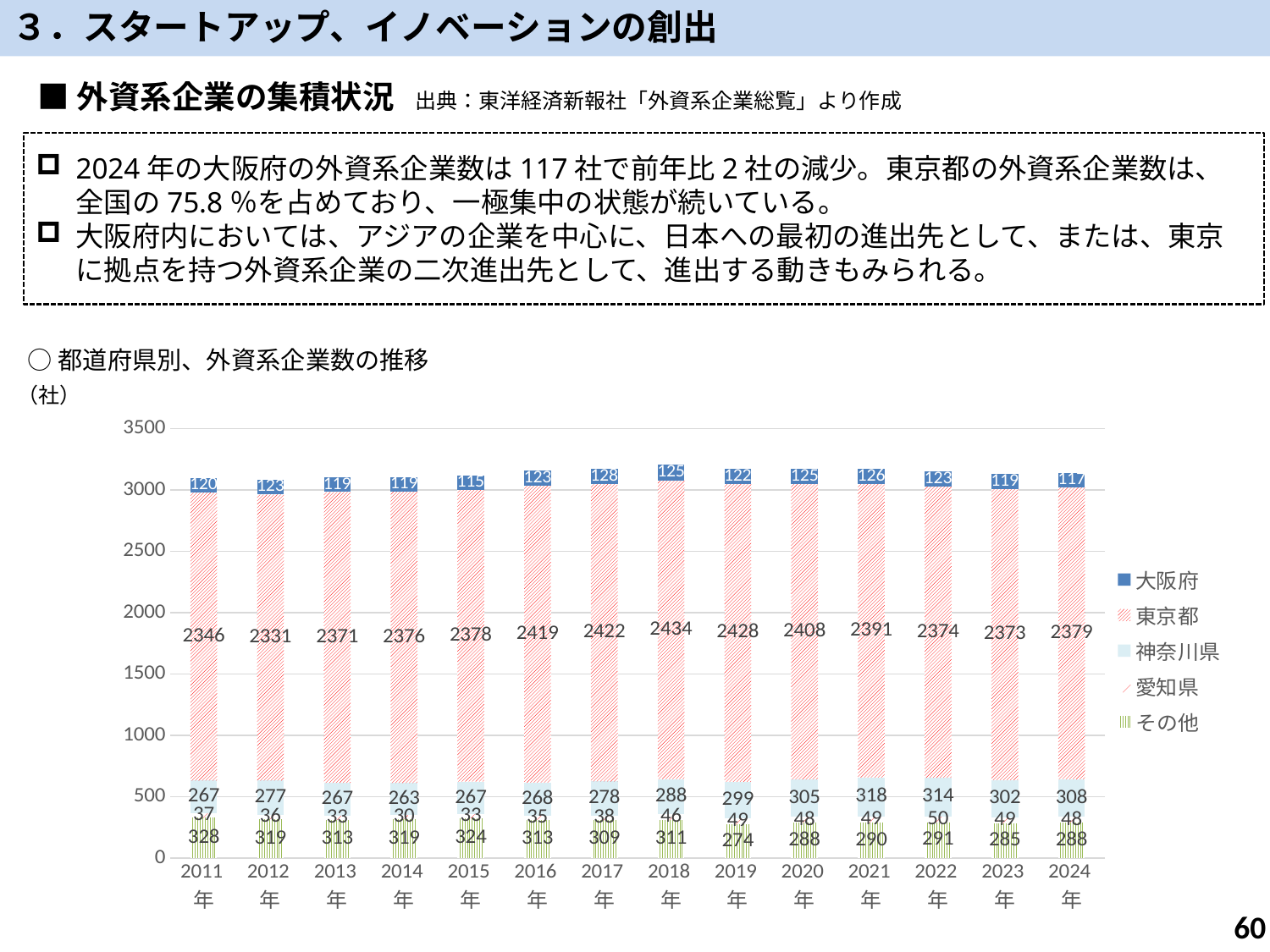
What is the value for その他 in 2019年? 274 In which year is the value for 大阪府 the lowest? 2015年 What is the difference between the 大阪府 values for 2023年 and 2024年? 2 What is the value for 東京都 in 2018年? 2434 What is the total of the stacked bar for 2024年? 3140 What is the value for 大阪府 in 2024年? 117 How many years are shown on the x axis? 14 What kind of chart is shown? Stacked bar chart Which is larger, the 神奈川県 value in 2011年 or in 2024年? 2024年 In which year is the value for 東京都 the highest? 2018年 What is the value for 神奈川県 in 2021年? 318 How many series does the legend list? 5